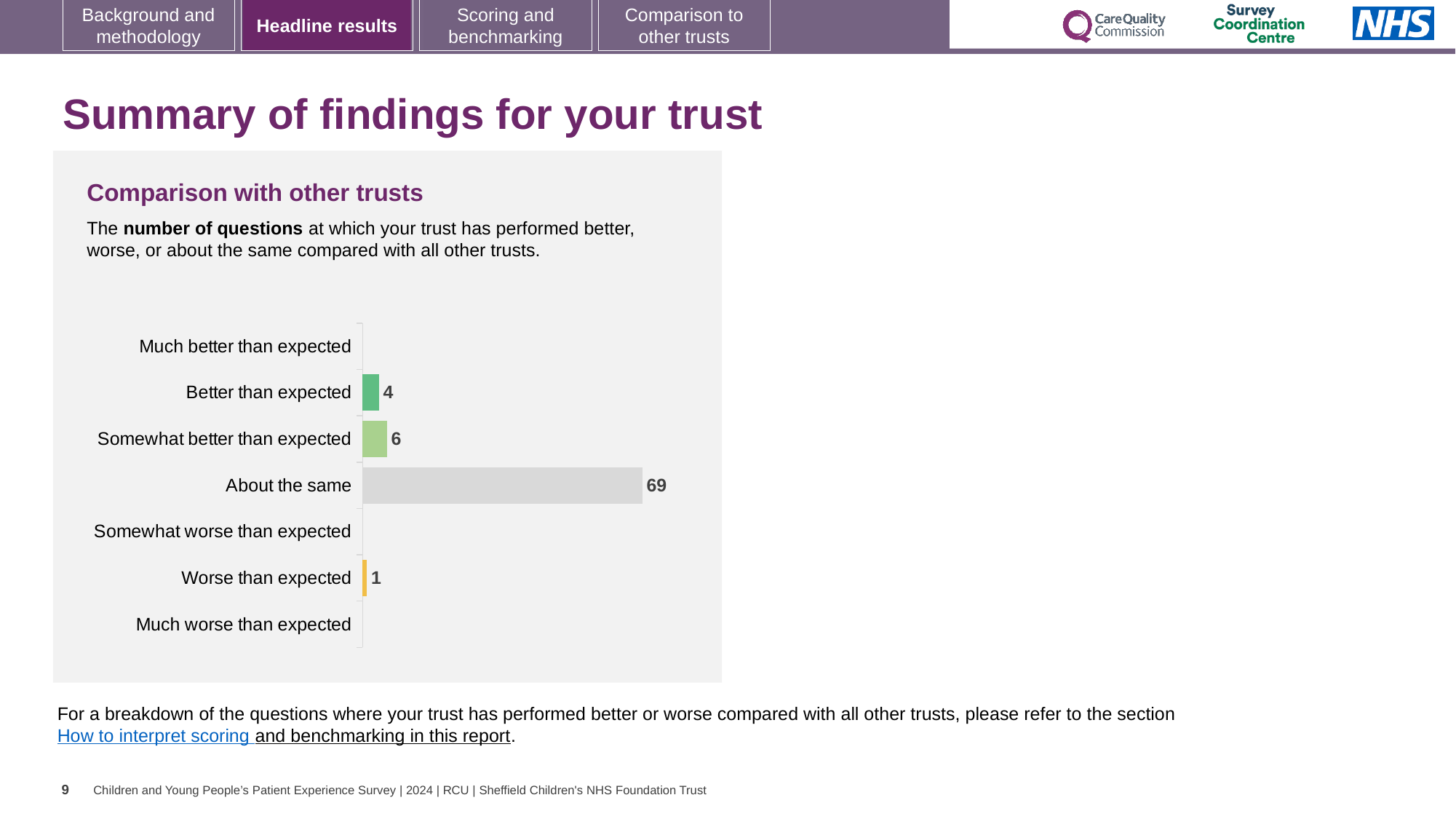
What is the value for 'Better than expected'? 4 What colour is the bar for 'Worse than expected'? Orange Which category has the highest number of questions? About the same What is the value for 'Somewhat better than expected'? 6 How many questions were rated 'About the same'? 69 What is the title of the chart section? Comparison with other trusts What is the difference between 'About the same' and 'Somewhat better than expected'? 63 What kind of chart is shown on the slide? Bar chart Which is larger, 'Better than expected' or 'Somewhat better than expected'? Somewhat better than expected What is the difference between 'Somewhat better than expected' and 'Better than expected'? 2 How many categories are listed on the chart's axis? 7 What is the value for 'Worse than expected'? 1